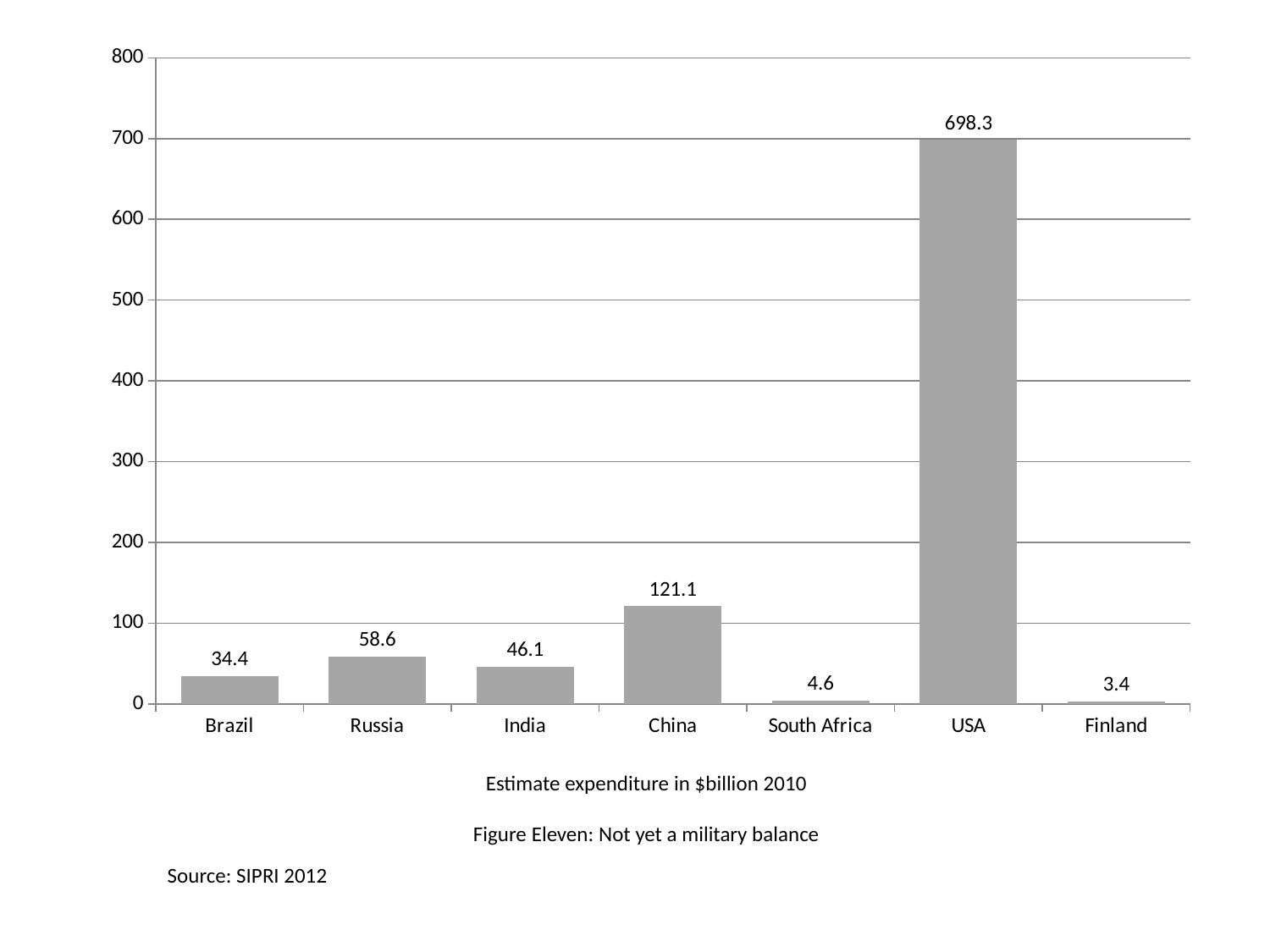
What is the estimated expenditure for Russia? 58.6 What kind of chart is shown on the slide? Bar chart What is the difference between Russia's and India's estimated expenditure? 12.5 What is the estimated expenditure for South Africa? 4.6 What is the estimated expenditure for China? 121.1 What is the source cited for the chart? SIPRI 2012 Which country has the highest estimated expenditure? USA Is the value for China greater or less than 100? greater What is the difference between the USA's and China's estimated expenditure? 577.2 Which country has the lowest estimated expenditure? Finland Which has a larger estimated expenditure, Brazil or India? India How many countries are shown on the chart? 7